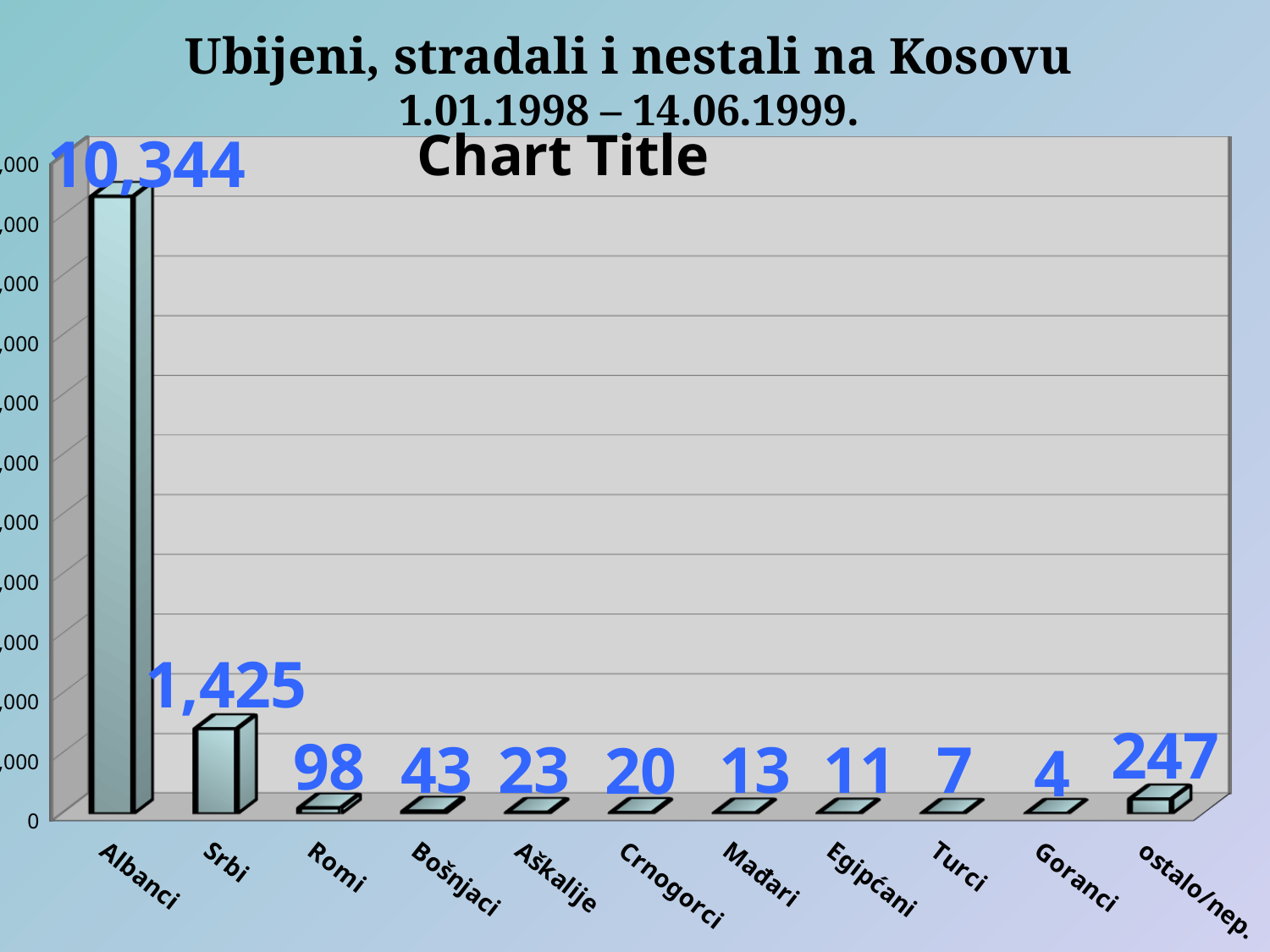
What is the difference between the values for Albanci and Srbi? 8,919 What is the value for Albanci? 10,344 What is the title of the slide above the chart? Ubijeni, stradali i nestali na Kosovu 1.01.1998 – 14.06.1999. Which is larger, the value for Bošnjaci or the value for Aškalije? Bošnjaci What is the value for Turci? 7 What is the value for Romi? 98 Which category has the highest value? Albanci What kind of chart is shown on the slide? Bar chart Which category has the lowest value? Goranci What is the value for ostalo/nep.? 247 What is the value for Srbi? 1,425 How many categories are shown on the x axis? 11